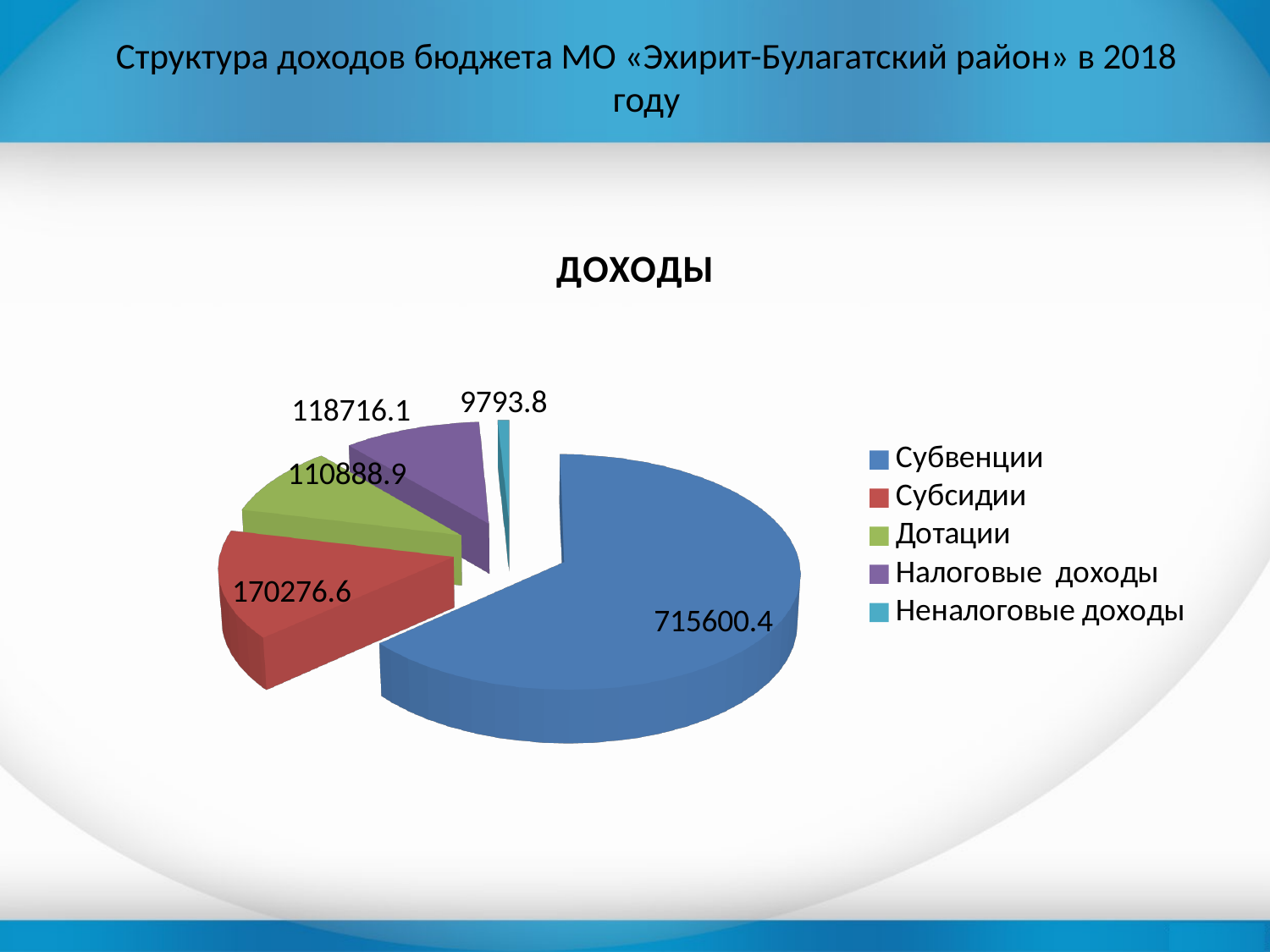
What is the value for Налоговые доходы? 118716.1 What is the value for Субсидии? 170276.6 Which is larger, Дотации or Налоговые доходы? Налоговые доходы How many categories does the legend list? 5 What type of chart is shown on the slide? Pie chart Which category has the smallest slice? Неналоговые доходы Which category has the largest slice? Субвенции What is the value for Субвенции? 715600.4 What is the difference between the values for Субвенции and Субсидии? 545323.8 What is the value for Неналоговые доходы? 9793.8 What is the value for Дотации? 110888.9 What is the title of the chart? ДОХОДЫ